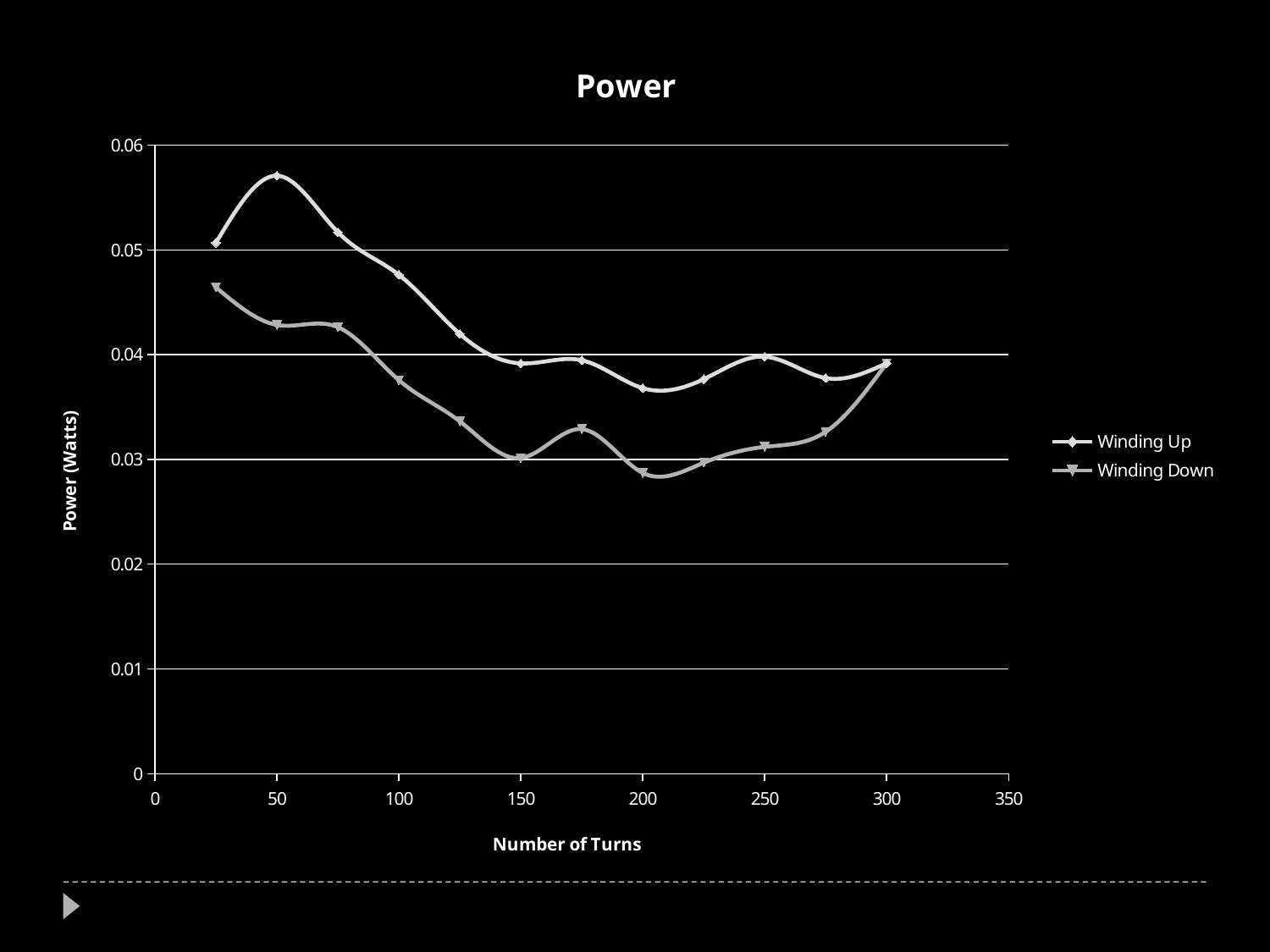
How many data points are plotted for the Winding Up series? 12 Is the Winding Up value at 50 turns greater or less than 0.05? greater What is the title of the chart? Power At which number of turns does the Winding Up series reach its highest power? 50 How many series does the legend list? 2 What kind of chart is shown on the slide? line chart What is the label of the vertical axis? Power (Watts) At 100 turns, which series has the higher power, Winding Up or Winding Down? Winding Up Is the Winding Up value at 100 turns greater or less than 0.04? greater Is the Winding Down value at 25 turns greater or less than 0.05? less